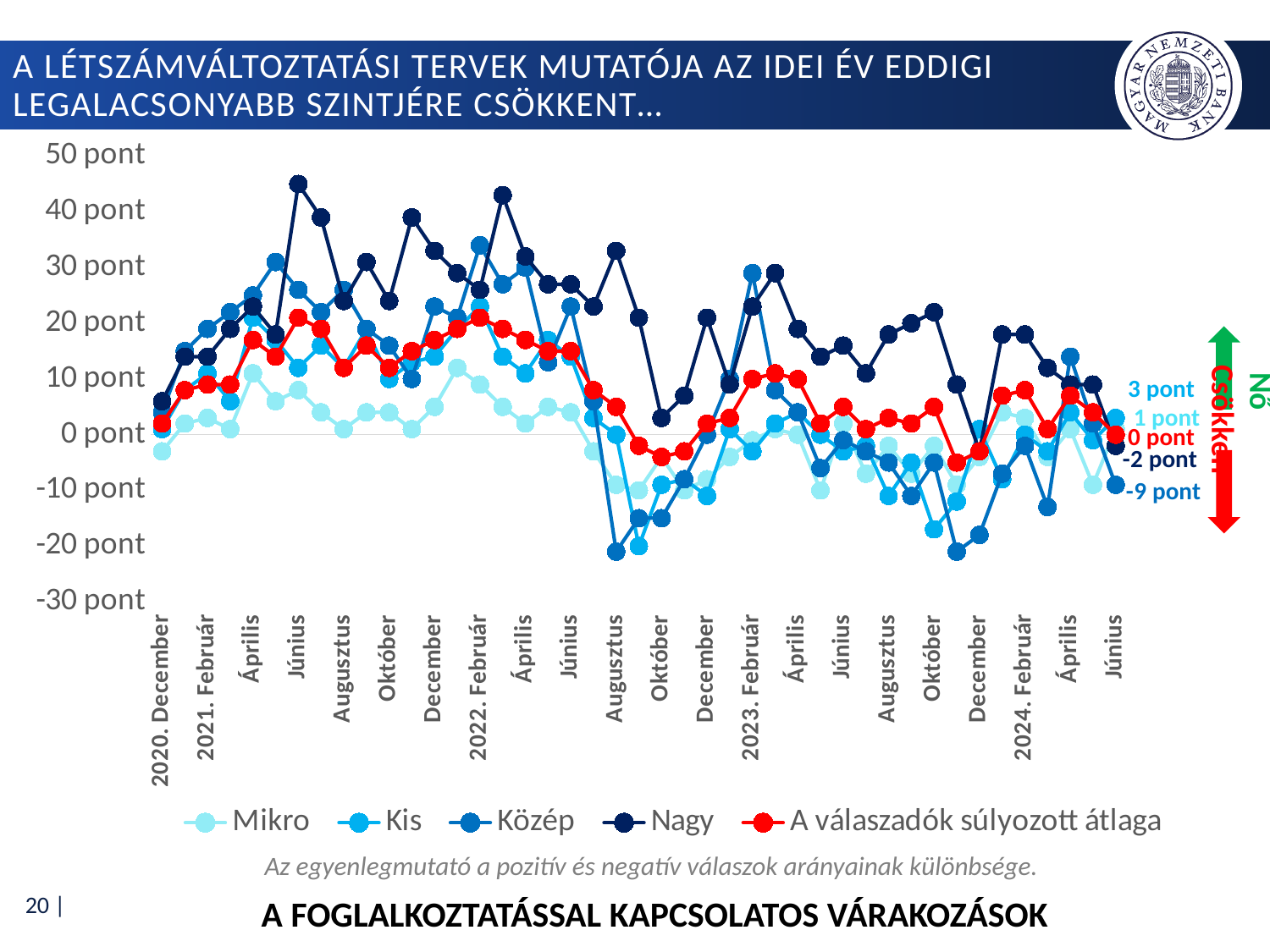
How many series does the legend list? 5 Which series has the lowest value at the last data point (2024 Június)? Közép Is the value of the Nagy series in 2021 Június greater or less than 40 pont? greater Which series has the highest value at the last data point (2024 Június)? Kis What is the difference between the Kis and Közép values at the last data point (2024 Június)? 12 pont What is the value of the Mikro series at the last data point (2024 Június)? 1 pont Which series is drawn in red in the legend? A válaszadók súlyozott átlaga What is the value of the Kis series at the last data point (2024 Június)? 3 pont What kind of chart is shown on the slide? line chart What is the value of the Közép series at the last data point (2024 Június)? -9 pont What is the value of the Nagy series at the last data point (2024 Június)? -2 pont What is the value of 'A válaszadók súlyozott átlaga' at the last data point (2024 Június)? 0 pont